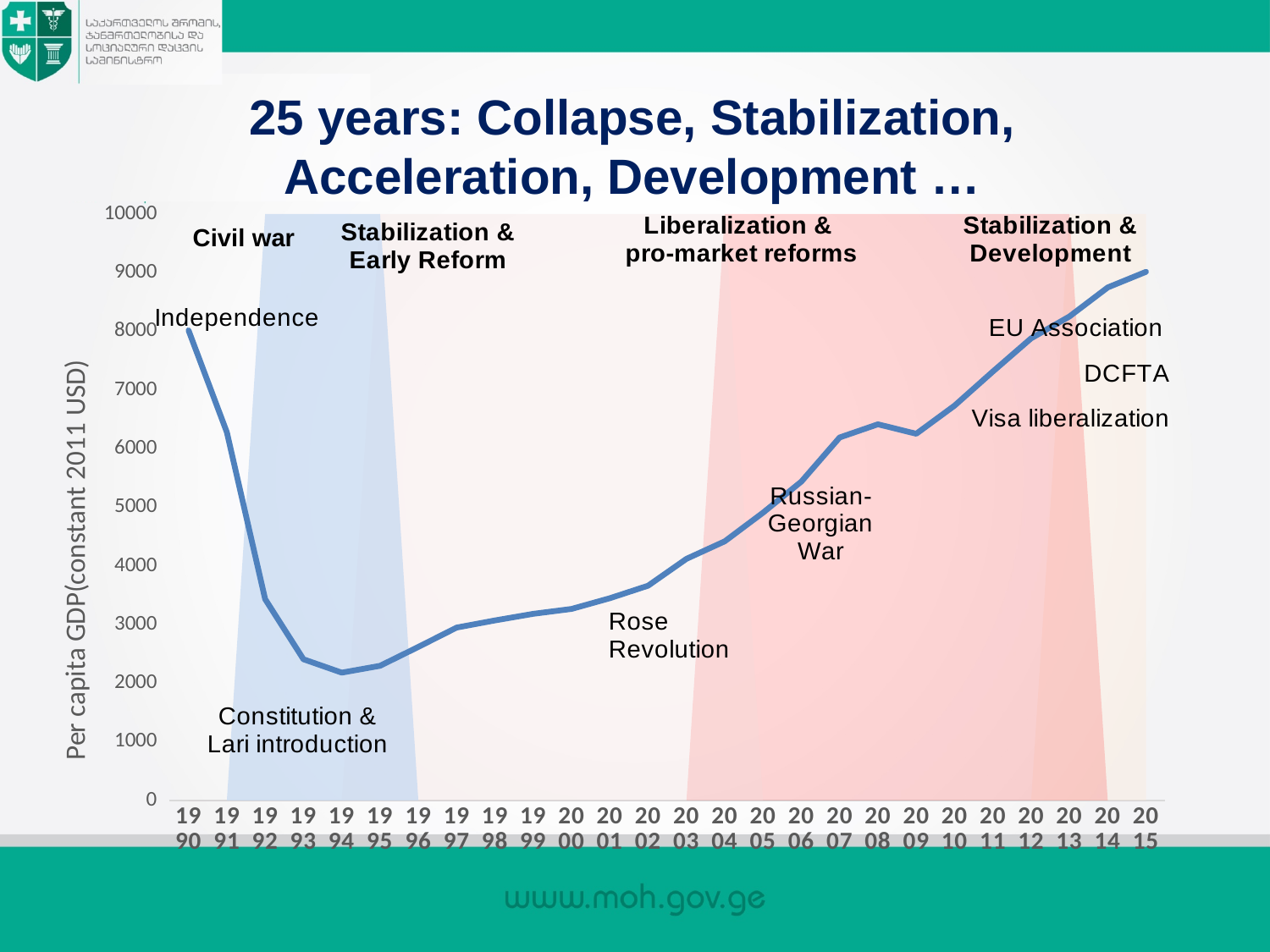
Does per capita GDP rise or fall between 1990 and 1994? fall Is the value for 2008 greater or less than 6000? greater How many years are plotted along the x axis of the chart? 26 What is the title of the slide containing the chart? 25 years: Collapse, Stabilization, Acceleration, Development … Is the value for 2015 greater or less than 8000? greater In which year is per capita GDP at its lowest on the chart? 1994 What is the label of the vertical axis of the chart? Per capita GDP(constant 2011 USD) Is the value for 2003 greater or less than 3000? greater Which year has the higher per capita GDP, 1990 or 2015? 2015 What kind of chart is shown on the slide? line chart In which year is per capita GDP at its highest on the chart? 2015